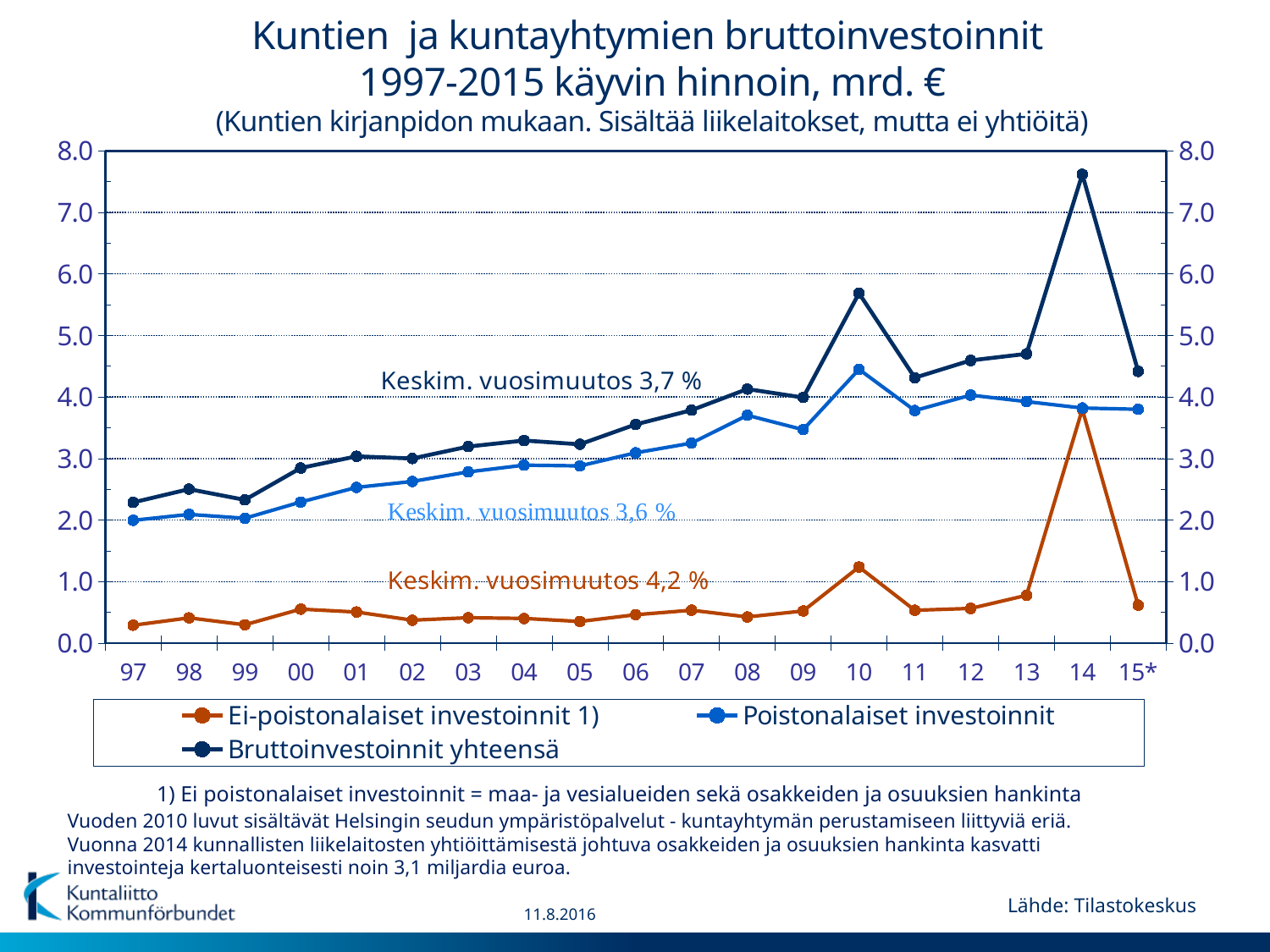
In which year does the Poistonalaiset investoinnit series reach its highest value? 10 How many years are plotted along the x axis? 19 How many series does the legend list? 3 Does the Poistonalaiset investoinnit series generally rise or fall from 97 to 10? rise Is the value for Ei-poistonalaiset investoinnit 1) in 97 greater or less than 1.0? less Is the value for Bruttoinvestoinnit yhteensä in 10 greater or less than 5.0? greater Which is larger: Bruttoinvestoinnit yhteensä in 10 or in 13? 10 What kind of chart is shown on the slide? line chart In which year does the Bruttoinvestoinnit yhteensä series reach its highest value? 14 What average annual change (Keskim. vuosimuutos) is annotated for the Bruttoinvestoinnit yhteensä series? 3,7 % Is the value for Bruttoinvestoinnit yhteensä in 14 greater or less than 7.0? greater In which year does the Ei-poistonalaiset investoinnit 1) series reach its highest value? 14